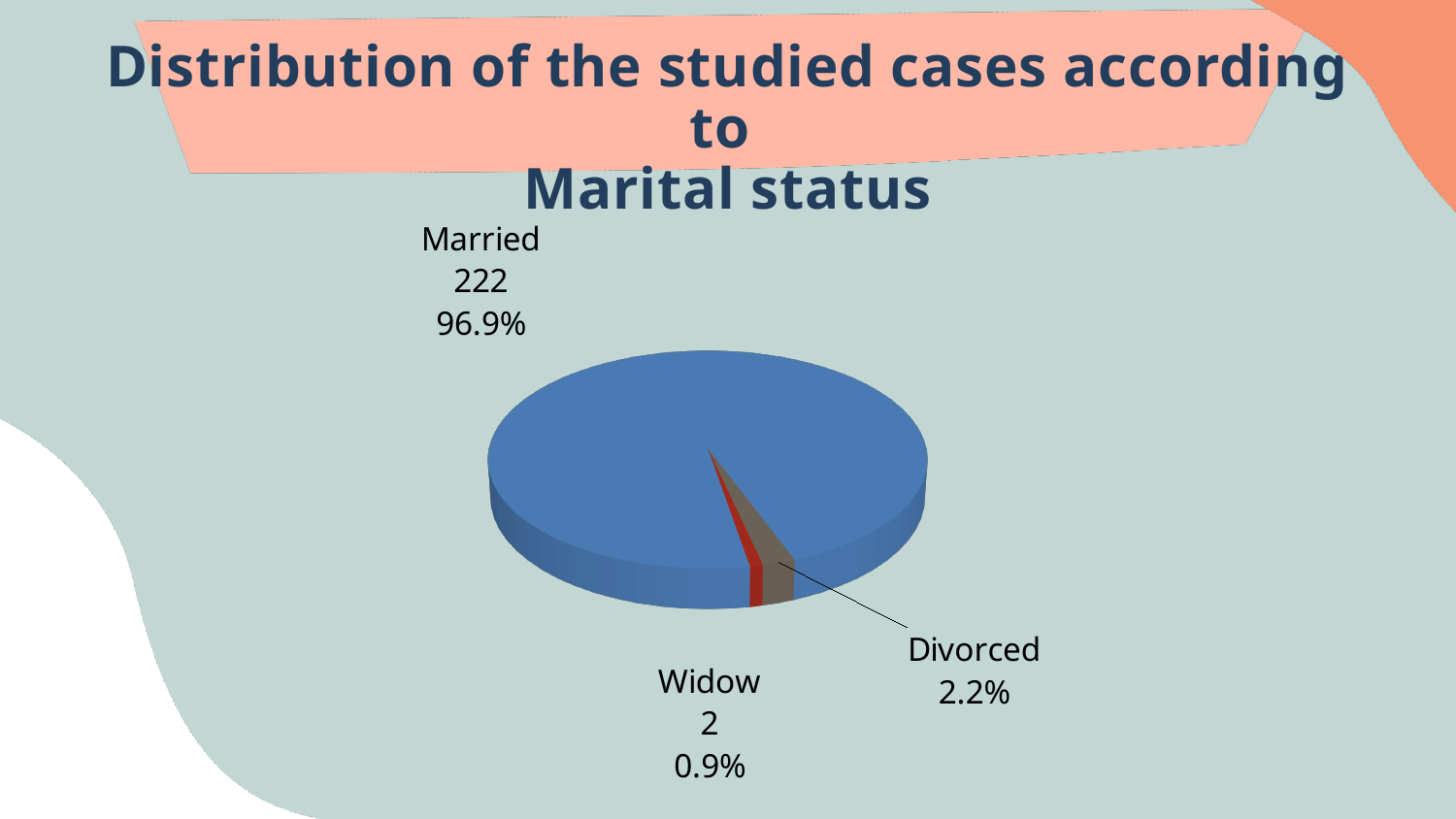
Which marital status category has the smallest share? Widow What share of the pie does Married represent? 96.9% What is the difference between the number of Married cases and the number of Widow cases? 220 What share of the pie does Divorced represent? 2.2% What is the title of the chart on the slide? Distribution of the studied cases according to Marital status What is the number of cases for Widow? 2 Which has a larger share, Divorced or Widow? Divorced Which marital status category has the largest share? Married How many categories does the pie chart show? 3 What is the number of cases for Married? 222 What share of the pie does Widow represent? 0.9% What kind of chart is shown on the slide? pie chart